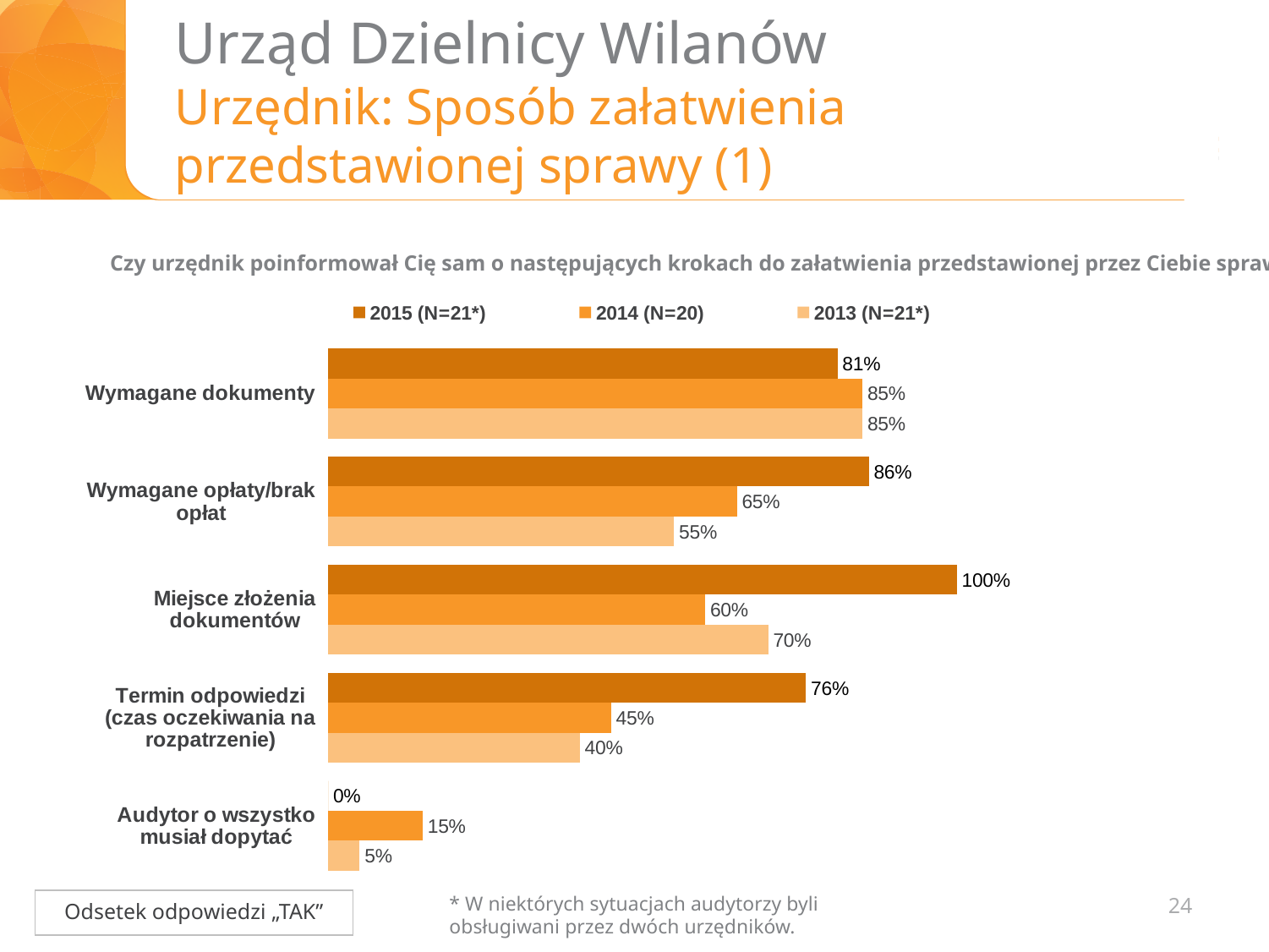
What kind of chart is shown on the slide? bar chart Which category has the highest value in the 2015 (N=21*) series? Miejsce złożenia dokumentów What is the difference between the 2015 and 2013 values for "Wymagane opłaty/brak opłat"? 31% For "Miejsce złożenia dokumentów", which is larger: the 2014 value or the 2013 value? 2013 What does the box at the bottom left of the slide say the chart shows? Odsetek odpowiedzi „TAK” What is the value for "Termin odpowiedzi (czas oczekiwania na rozpatrzenie)" in the 2014 (N=20) series? 45% How many categories are shown on the chart? 5 What is the value for "Wymagane dokumenty" in the 2015 (N=21*) series? 81% What is the value for "Audytor o wszystko musiał dopytać" in the 2013 (N=21*) series? 5% What is the value for "Miejsce złożenia dokumentów" in the 2015 (N=21*) series? 100% Which category has the lowest value in the 2014 (N=20) series? Audytor o wszystko musiał dopytać How many series does the legend list? 3